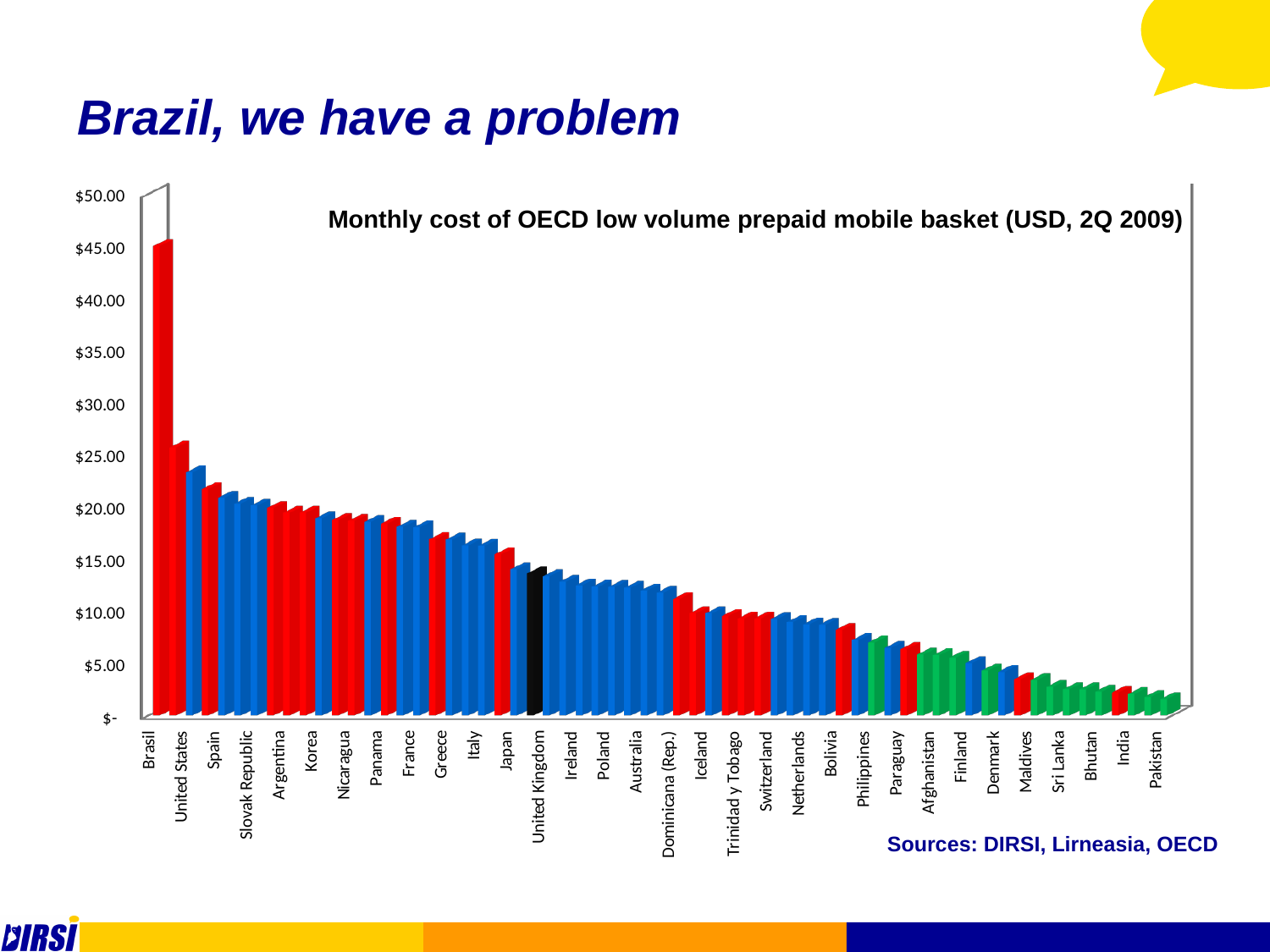
What is the title of the chart? Monthly cost of OECD low volume prepaid mobile basket (USD, 2Q 2009) What kind of chart is shown on the slide? bar chart Is the value for Pakistan greater or less than $5.00? less Is the value for Brasil greater or less than $40.00? greater What colour is the bar for Brasil? red Which has a higher monthly cost, Brasil or United Kingdom? Brasil Which country has the highest monthly cost in the chart? Brasil Which has a higher monthly cost, United Kingdom or Pakistan? United Kingdom Is the value for Brasil greater or less than $50.00? less Do the values generally rise or fall from left to right along the x axis? fall